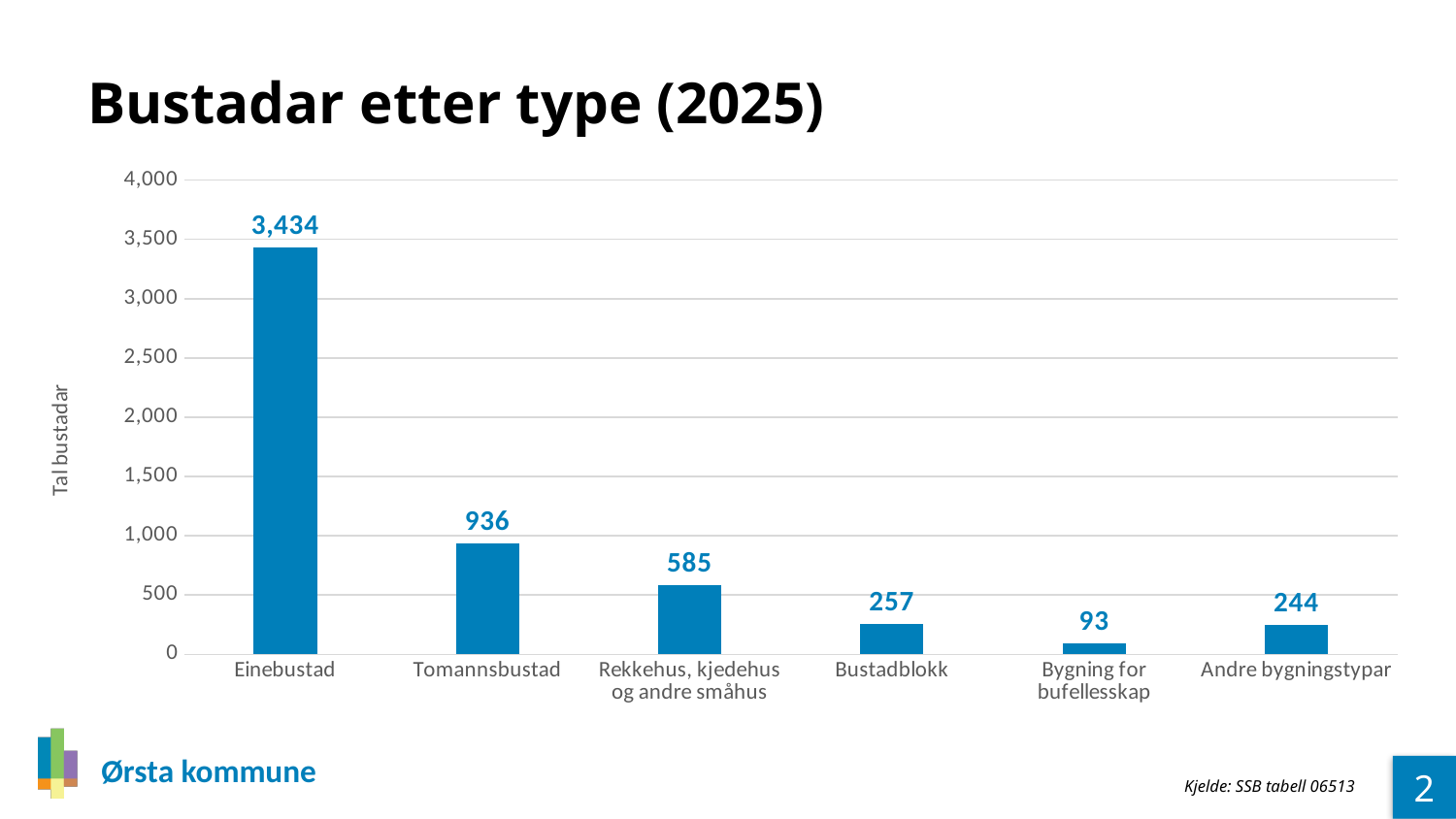
What kind of chart is shown on the slide? Bar chart Which category has the highest value? Einebustad Is the value for Rekkehus, kjedehus og andre småhus greater or less than 500? greater What is the value for Bygning for bufellesskap? 93 What is the value for Tomannsbustad? 936 Which category has the lowest value? Bygning for bufellesskap Which is larger, the value for Bustadblokk or the value for Andre bygningstypar? Bustadblokk What is the title of the chart? Bustadar etter type (2025) What is the value for Andre bygningstypar? 244 How many categories are shown on the x axis? 6 What is the difference between the values for Einebustad and Tomannsbustad? 2,498 What is the value for Einebustad? 3,434